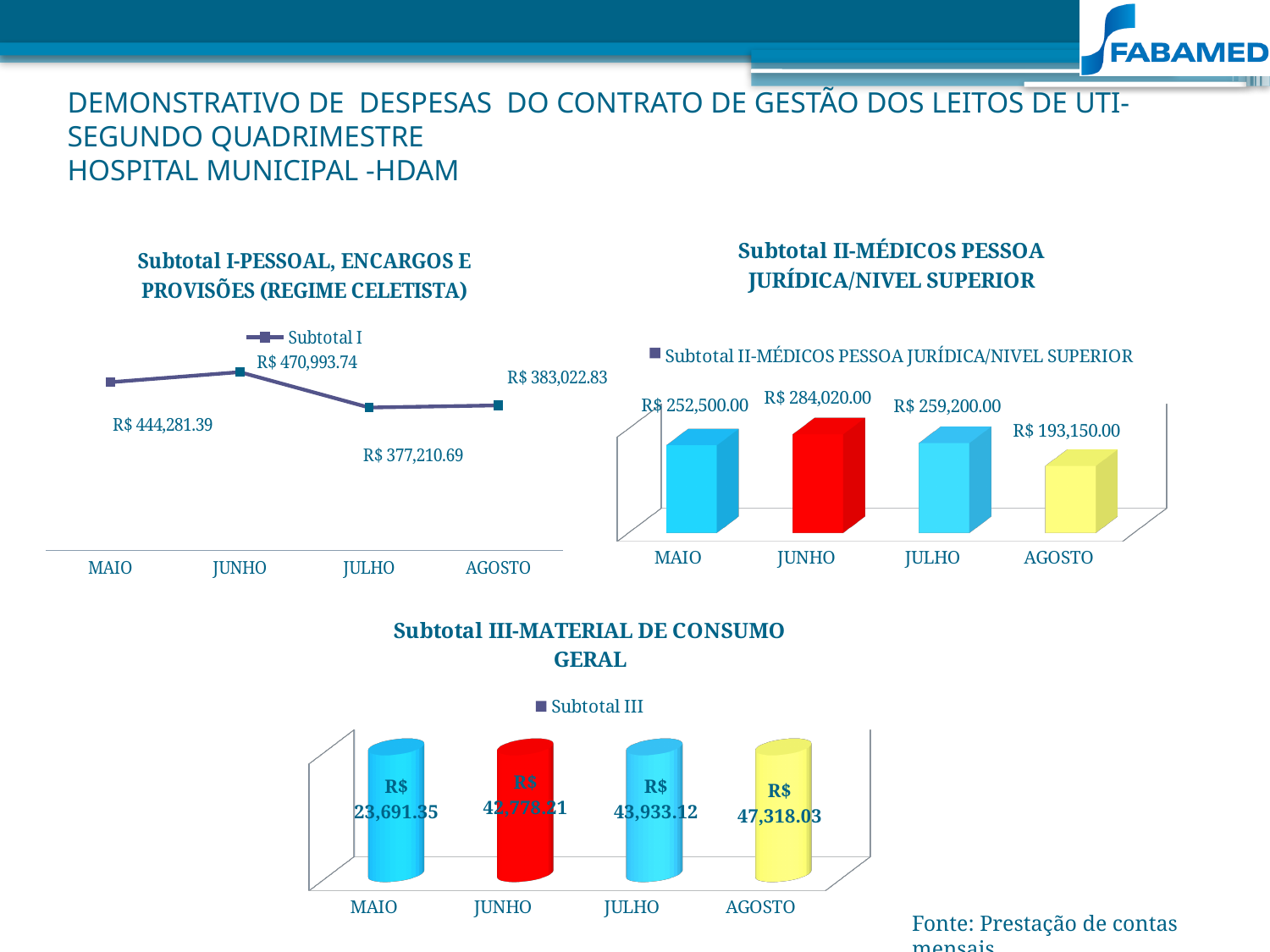
In the Subtotal III-MATERIAL DE CONSUMO GERAL chart, do the values rise or fall from MAIO to AGOSTO? Rise In the Subtotal II-MÉDICOS PESSOA JURÍDICA/NIVEL SUPERIOR chart, what is the value for AGOSTO? R$ 193,150.00 In the Subtotal II-MÉDICOS PESSOA JURÍDICA/NIVEL SUPERIOR chart, which month has the highest value? JUNHO In the Subtotal III-MATERIAL DE CONSUMO GERAL chart, what is the value for MAIO? R$ 23,691.35 In the Subtotal II-MÉDICOS PESSOA JURÍDICA/NIVEL SUPERIOR chart, what is the difference between the JUNHO and AGOSTO values? R$ 90,870.00 In the Subtotal III-MATERIAL DE CONSUMO GERAL chart, which month has the highest value? AGOSTO What kind of chart is the Subtotal I-PESSOAL, ENCARGOS E PROVISÕES chart? Line chart In the Subtotal II-MÉDICOS PESSOA JURÍDICA/NIVEL SUPERIOR chart, how many months are shown? 4 In the Subtotal III-MATERIAL DE CONSUMO GERAL chart, what is the difference between the AGOSTO and MAIO values? R$ 23,626.68 In the Subtotal I-PESSOAL, ENCARGOS E PROVISÕES chart, which month has the lowest value? JULHO In the Subtotal I-PESSOAL, ENCARGOS E PROVISÕES chart, what is the value for JUNHO? R$ 470,993.74 In the Subtotal I-PESSOAL, ENCARGOS E PROVISÕES chart, what is the difference between the JUNHO and JULHO values? R$ 93,783.05